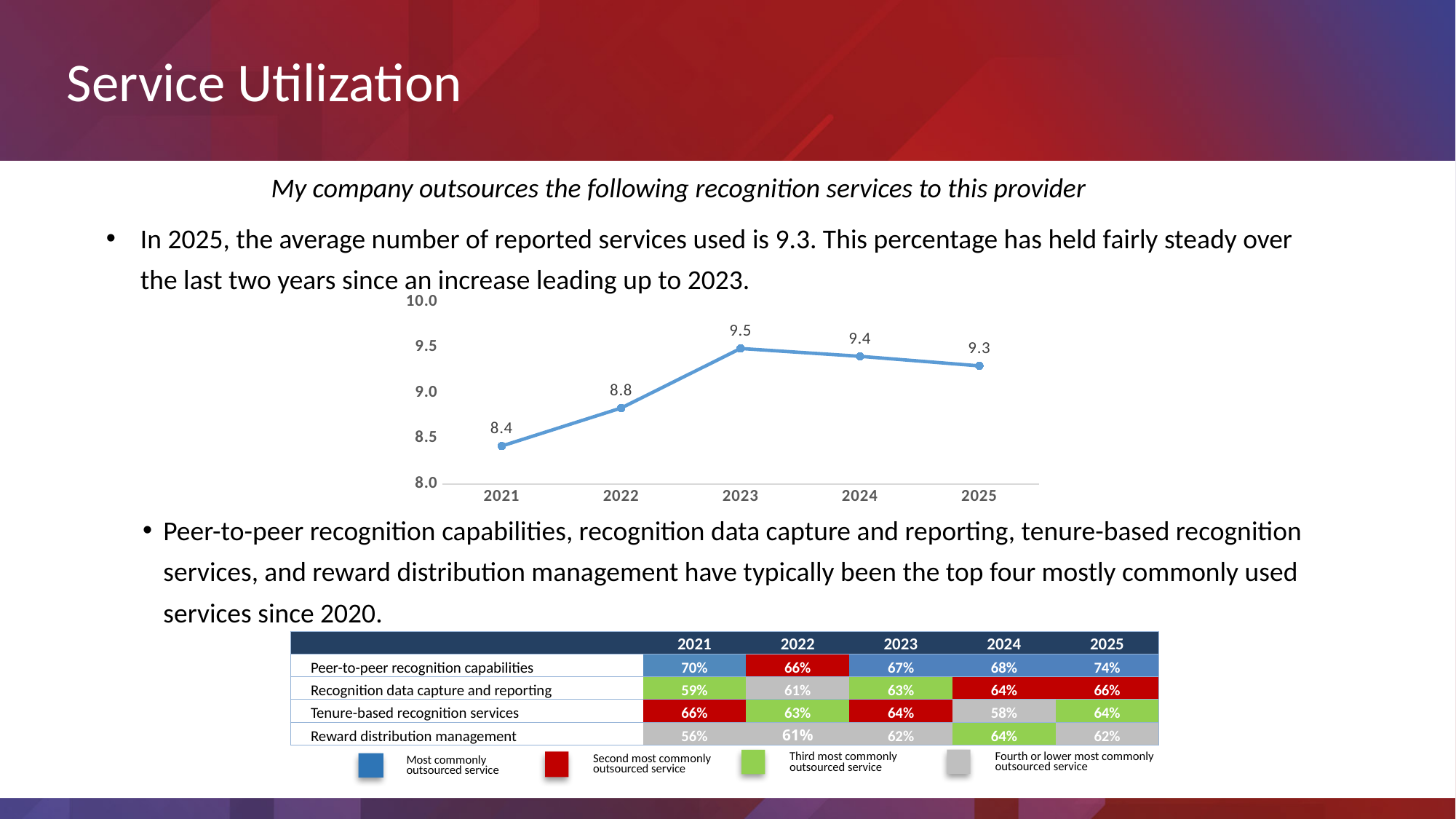
Which year has the lowest value in the line chart? 2021 What kind of chart is shown on the slide? line chart What is the value plotted for 2023 in the line chart? 9.5 What is the difference between the 2023 value and the 2021 value in the line chart? 1.1 What is the difference between the 2022 value and the 2021 value in the line chart? 0.4 Does the line chart rise or fall from 2021 to 2023? rise What is the value plotted for 2025 in the line chart? 9.3 Is the value for 2022 in the line chart greater or less than 9.0? less What is the value plotted for 2021 in the line chart? 8.4 How many years are plotted on the x axis of the line chart? 5 Which year has the highest value in the line chart? 2023 In the line chart, is the value for 2024 larger or smaller than the value for 2022? larger